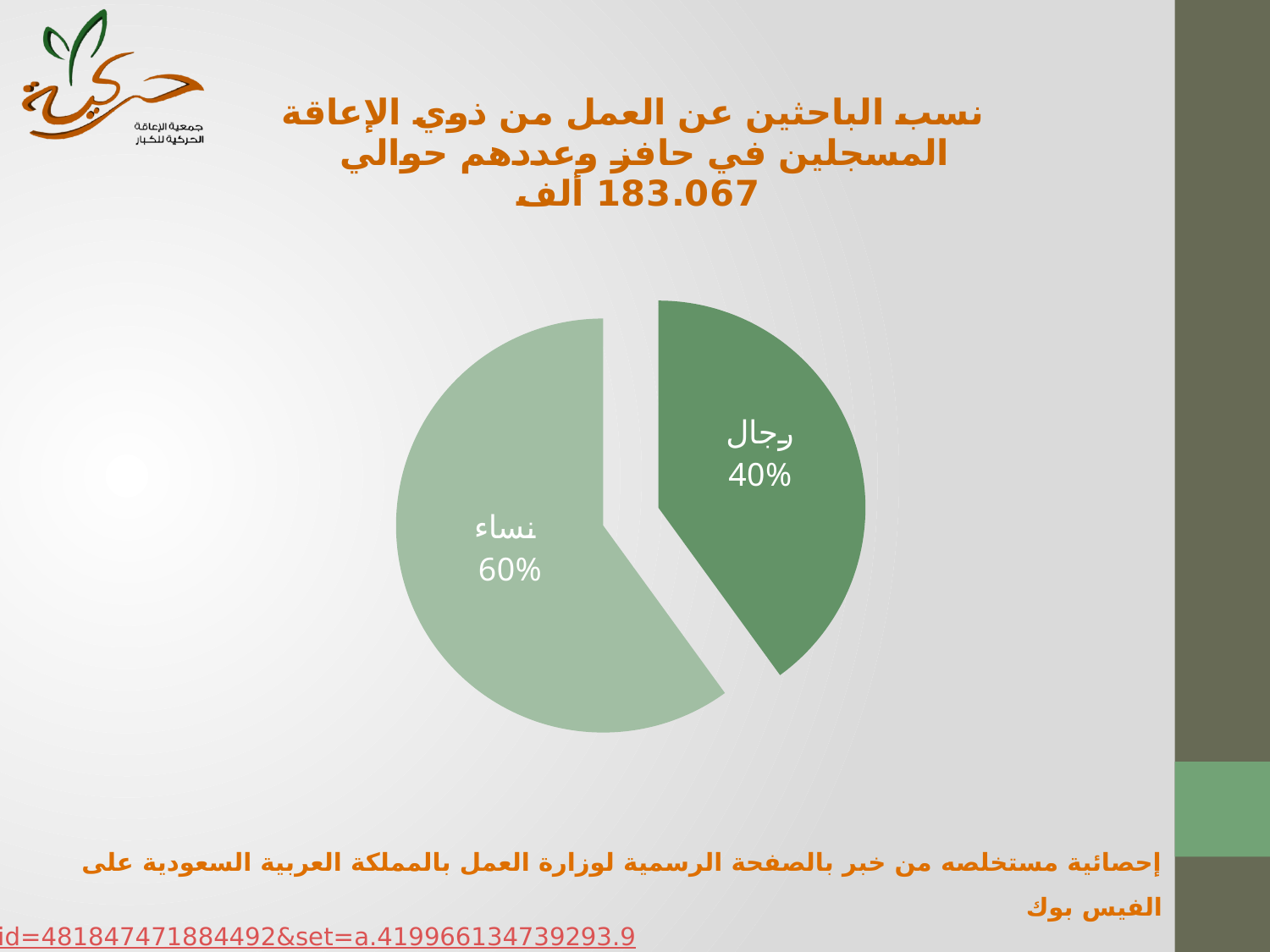
Which is larger, the share for رجال or the share for نساء? نساء Is the share for رجال greater or less than 50%? less What is the difference in percentage points between the نساء slice and the رجال slice? 20% What percentage of the pie is labelled رجال? 40% Which slice is drawn in the darker green colour? رجال What type of chart is shown on the slide? pie chart Which slice of the pie is the smallest? رجال Which slice of the pie is the largest? نساء Is the share for نساء greater or less than 50%? greater What total number of job seekers is stated in the slide title? 183.067 ألف How many slices does the pie chart have? 2 What percentage of the pie is labelled نساء? 60%